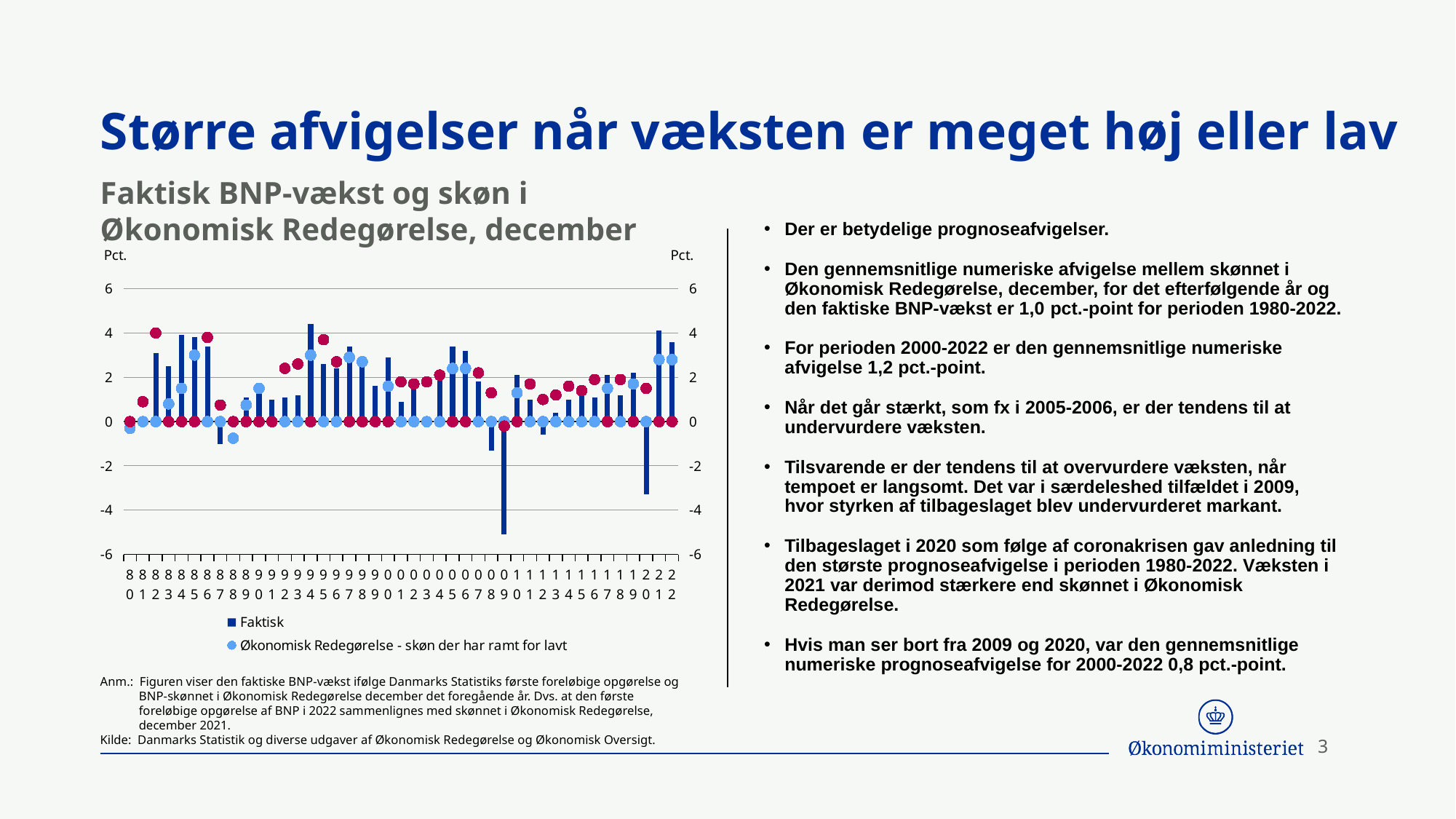
What is the first year shown on the x axis of the chart? 80 Is the Faktisk value for 2005 greater or less than 4? less Which year has the lowest value for the Faktisk series? 2009 Is the Faktisk value for 2009 greater or less than -4? less What is the title of the chart? Faktisk BNP-vækst og skøn i Økonomisk Redegørelse, december Which is larger, the Faktisk value for 2005 or for 2008? 2005 Is the Faktisk value for 2008 greater or less than 0? less Which is larger, the Faktisk value for 2009 or for 2020? 2020 What kind of chart is shown on the slide? combination chart of bars and dot markers How many years are shown along the x axis of the chart? 43 What unit is shown on the vertical axes of the chart? Pct.